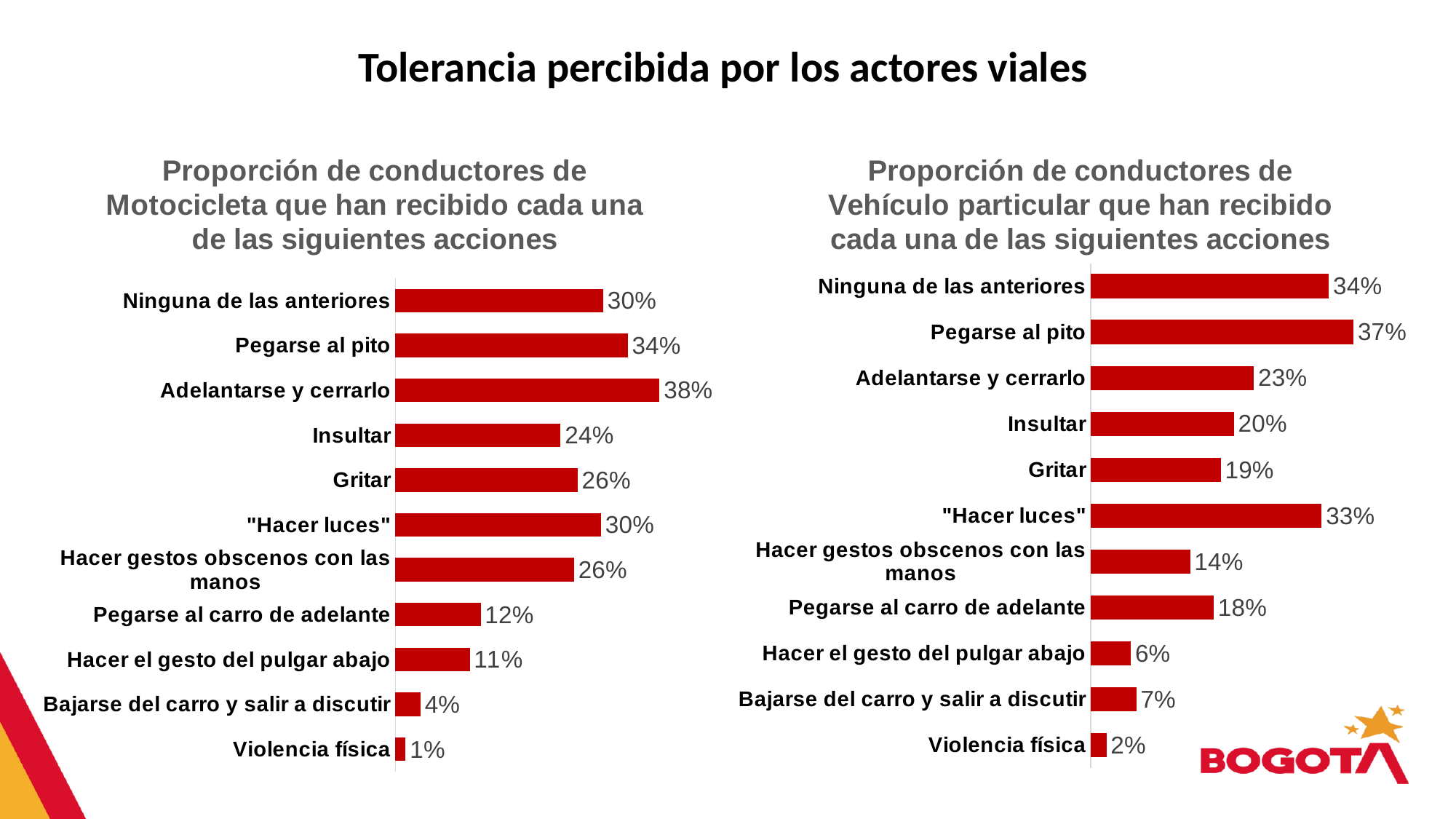
In the left chart (Motocicleta), what is the value for "Adelantarse y cerrarlo"? 38% In the left chart (Motocicleta), what is the difference between "Pegarse al carro de adelante" and "Hacer el gesto del pulgar abajo"? 1% In the right chart (Vehículo particular), which category has the highest value? Pegarse al pito What kind of chart is the left chart (Motocicleta)? Bar chart In the left chart (Motocicleta), which category has the lowest value? Violencia física In the left chart (Motocicleta), which category has the highest value? Adelantarse y cerrarlo In the right chart (Vehículo particular), which category has the lowest value? Violencia física How many categories does the right chart (Vehículo particular) show? 11 In the right chart (Vehículo particular), what is the difference between "Pegarse al pito" and "Adelantarse y cerrarlo"? 14% In the left chart (Motocicleta), which is larger: "Insultar" or "Gritar"? Gritar What is the main title of the slide? Tolerancia percibida por los actores viales In the right chart (Vehículo particular), what is the value for "Hacer luces"? 33%